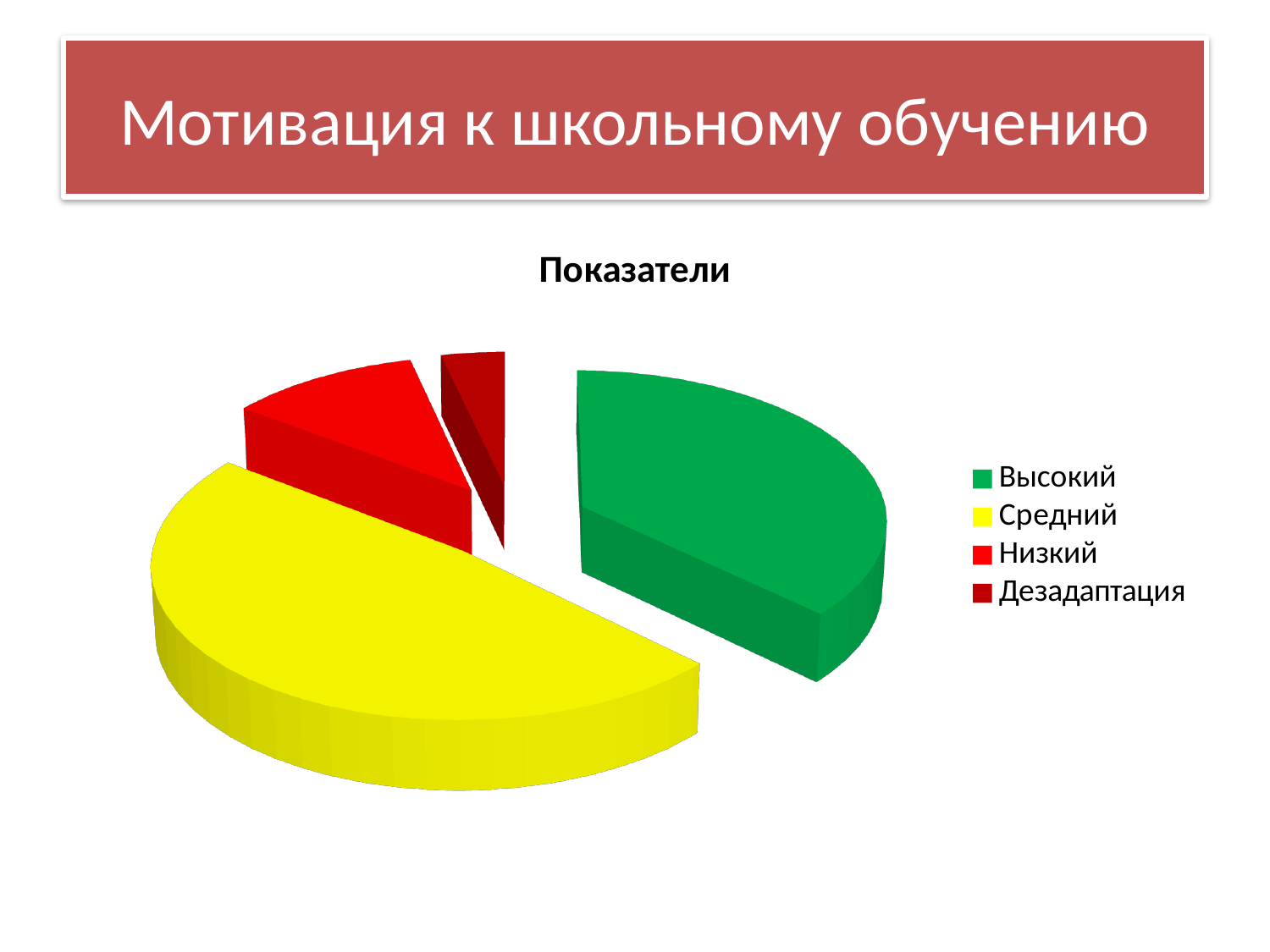
Which slice is larger, Низкий or Дезадаптация? Низкий What is the title of the chart? Показатели Which slice is larger, Средний or Высокий? Средний Which slice is larger, Высокий or Низкий? Высокий Which category has the largest slice of the pie? Средний Which category has the smallest slice of the pie? Дезадаптация What kind of chart is shown on the slide? pie chart Which category is shown in green? Высокий What colour is the slice for Средний? yellow How many slices does the pie chart have? 4